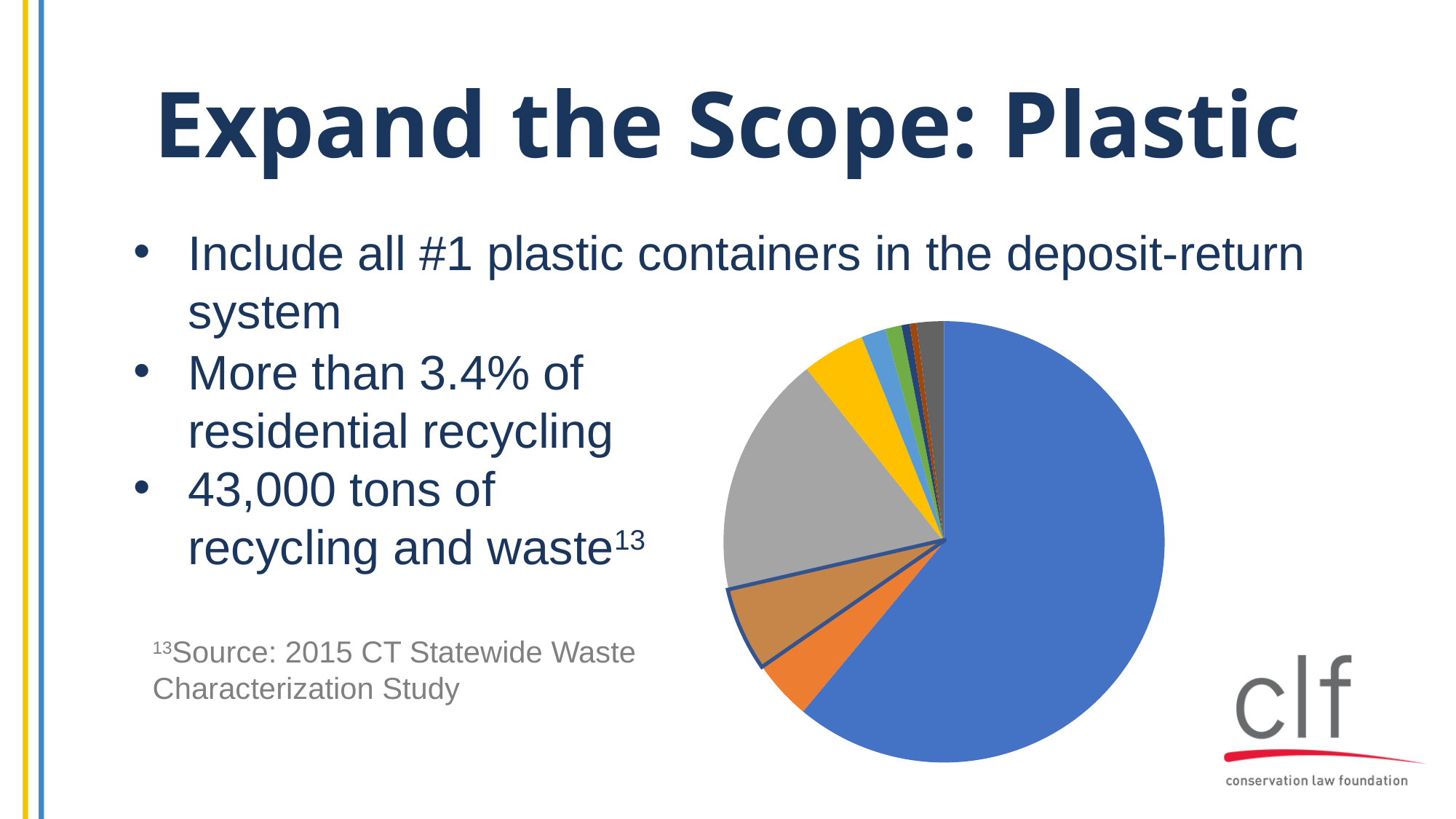
What kind of chart is shown on the slide? pie chart Does the blue slice of the pie chart cover more or less than half of the pie? more Which is larger in the pie chart, the gray slice or the yellow slice? the gray slice Does the pie chart display a legend? no Which colour slice is the largest in the pie chart? blue